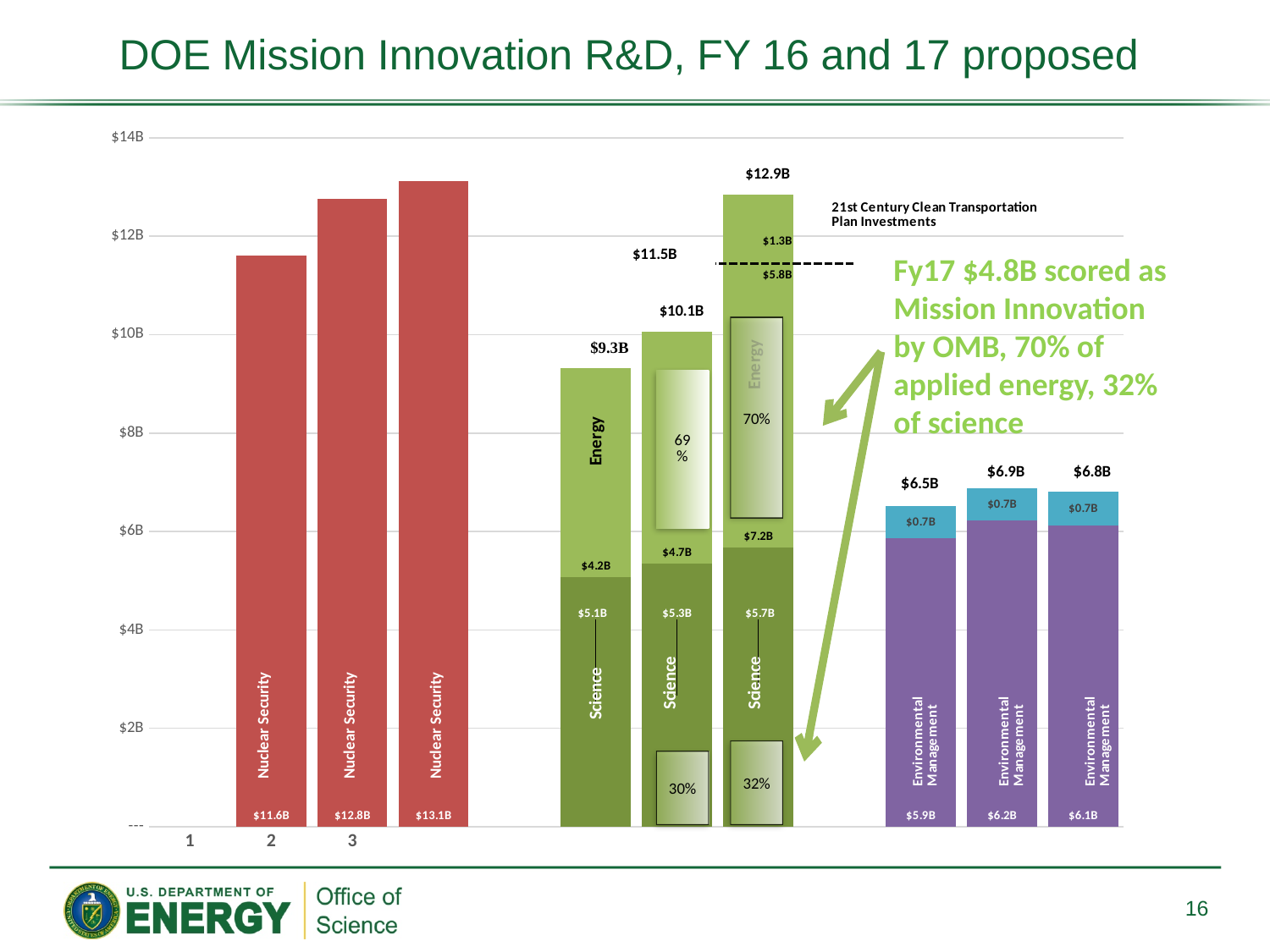
According to the slide, what percentage of science was scored as Mission Innovation by OMB for FY17? 32% What is the value printed at the bottom of the first Environmental Management bar? $5.9B What is the Science value printed in the third (rightmost) green stacked bar? $5.7B What is the Energy value printed in the second green stacked bar? $4.7B What is the total printed above the third (rightmost) Science/Energy stacked bar? $12.9B What kind of chart is shown on the slide? Stacked bar chart Is the value of the first Nuclear Security bar greater or less than $10B? greater Which is larger, the total of the second Environmental Management bar or the third? The second ($6.9B) What is the difference between the Energy values in the third and second green stacked bars ($7.2B and $4.7B)? $2.5B What is the value printed on the tallest Nuclear Security bar? $13.1B Which of the three Nuclear Security bars is the highest? The third one ($13.1B) What is the difference between the highest and lowest Nuclear Security bars? $1.5B